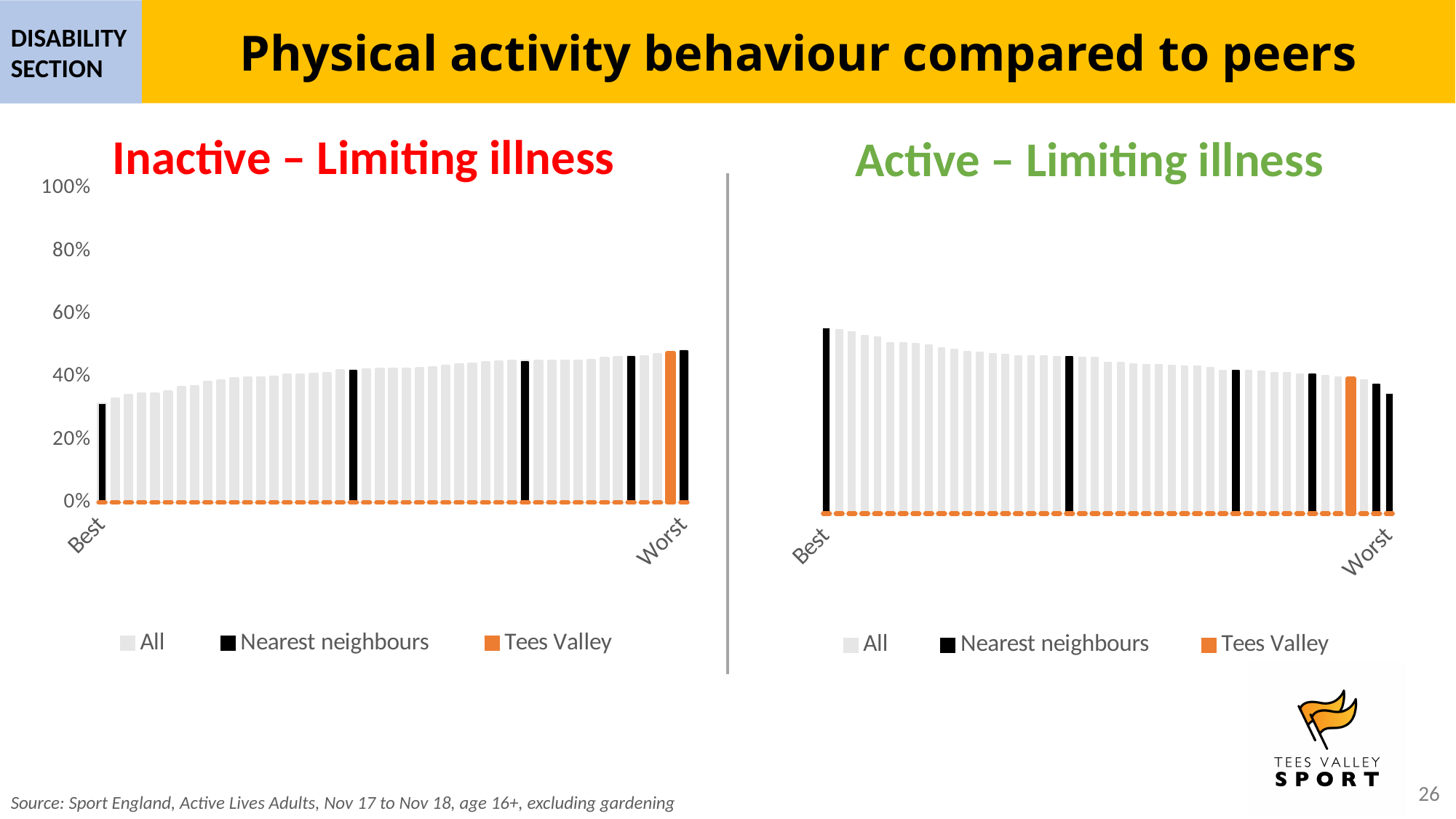
In the 'Inactive – Limiting illness' chart, is the value of the first (Best) bar greater or less than 20%? greater In the 'Inactive – Limiting illness' chart, is the Tees Valley value greater or less than 40%? greater In the 'Active – Limiting illness' chart, which is larger: the Tees Valley bar or the first (Best) bar? the first (Best) bar In the 'Inactive – Limiting illness' chart, is the value of the first (Best) bar greater or less than 40%? less What colour represents Tees Valley in the legend of the 'Inactive – Limiting illness' chart? orange How many series does the legend of the 'Active – Limiting illness' chart list? 3 In the 'Inactive – Limiting illness' chart, which is larger: the Tees Valley bar or the first (Best) bar? Tees Valley What kind of chart is the 'Inactive – Limiting illness' chart? bar chart In the 'Inactive – Limiting illness' chart, do the bar values rise or fall from Best to Worst? rise In the 'Active – Limiting illness' chart, do the bar values rise or fall from Best to Worst? fall What is the title of the chart on the right side of the slide? Active – Limiting illness